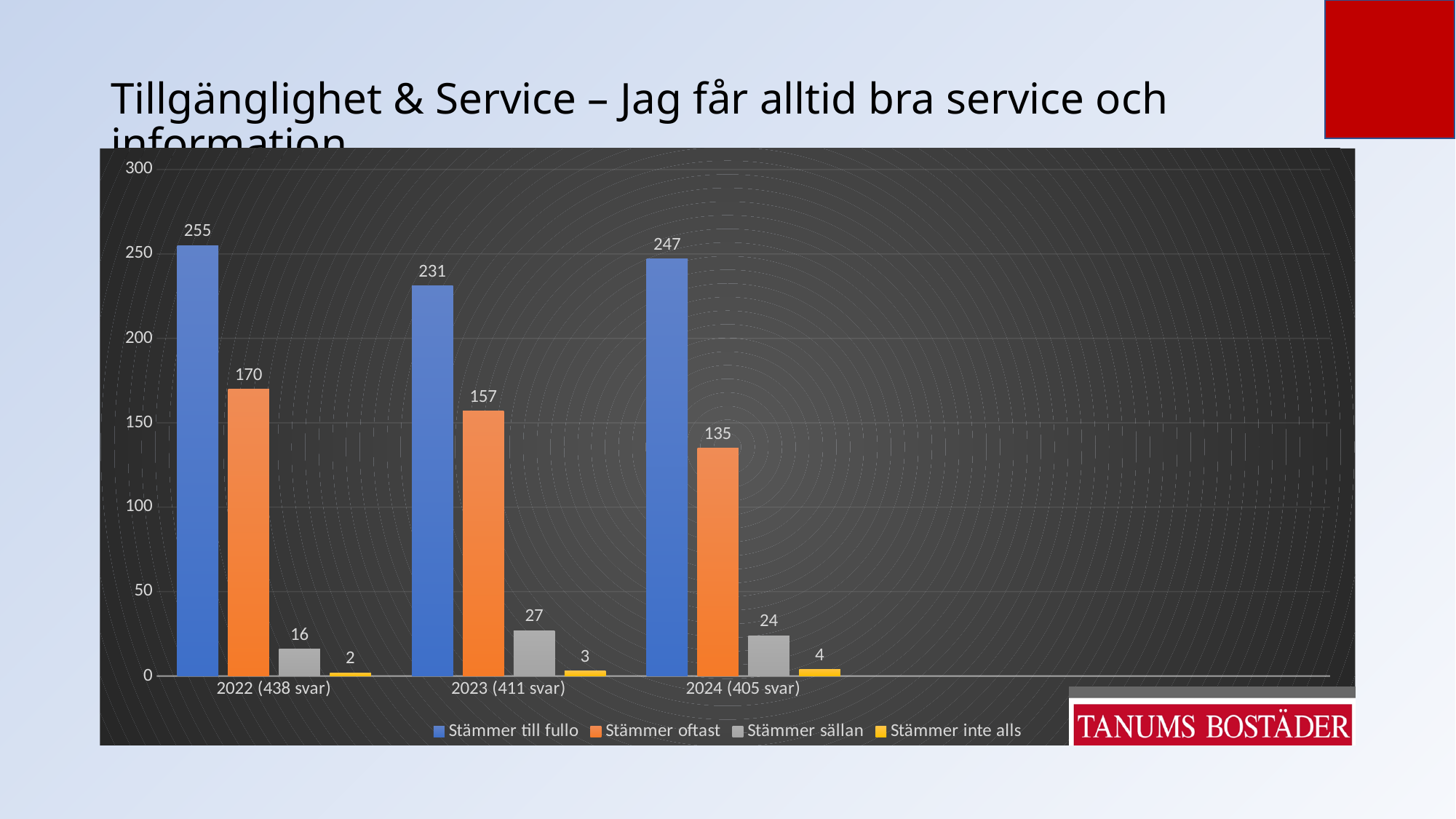
What is the value for "Stämmer sällan" in 2023 (411 svar)? 27 What is the value for "Stämmer oftast" in 2024 (405 svar)? 135 What kind of chart is shown on the slide? Bar chart Which year has the highest value for "Stämmer till fullo"? 2022 (438 svar) Which is larger: "Stämmer sällan" in 2023 (411 svar) or "Stämmer sällan" in 2024 (405 svar)? 2023 (411 svar) What is the difference between "Stämmer till fullo" and "Stämmer oftast" in 2023 (411 svar)? 74 Which year has the lowest value for "Stämmer oftast"? 2024 (405 svar) What is the value for "Stämmer till fullo" in 2022 (438 svar)? 255 How many year categories are shown on the x axis? 3 What is the value for "Stämmer inte alls" in 2022 (438 svar)? 2 How many series does the legend list? 4 Does the value for "Stämmer oftast" rise or fall from 2022 to 2024? Fall